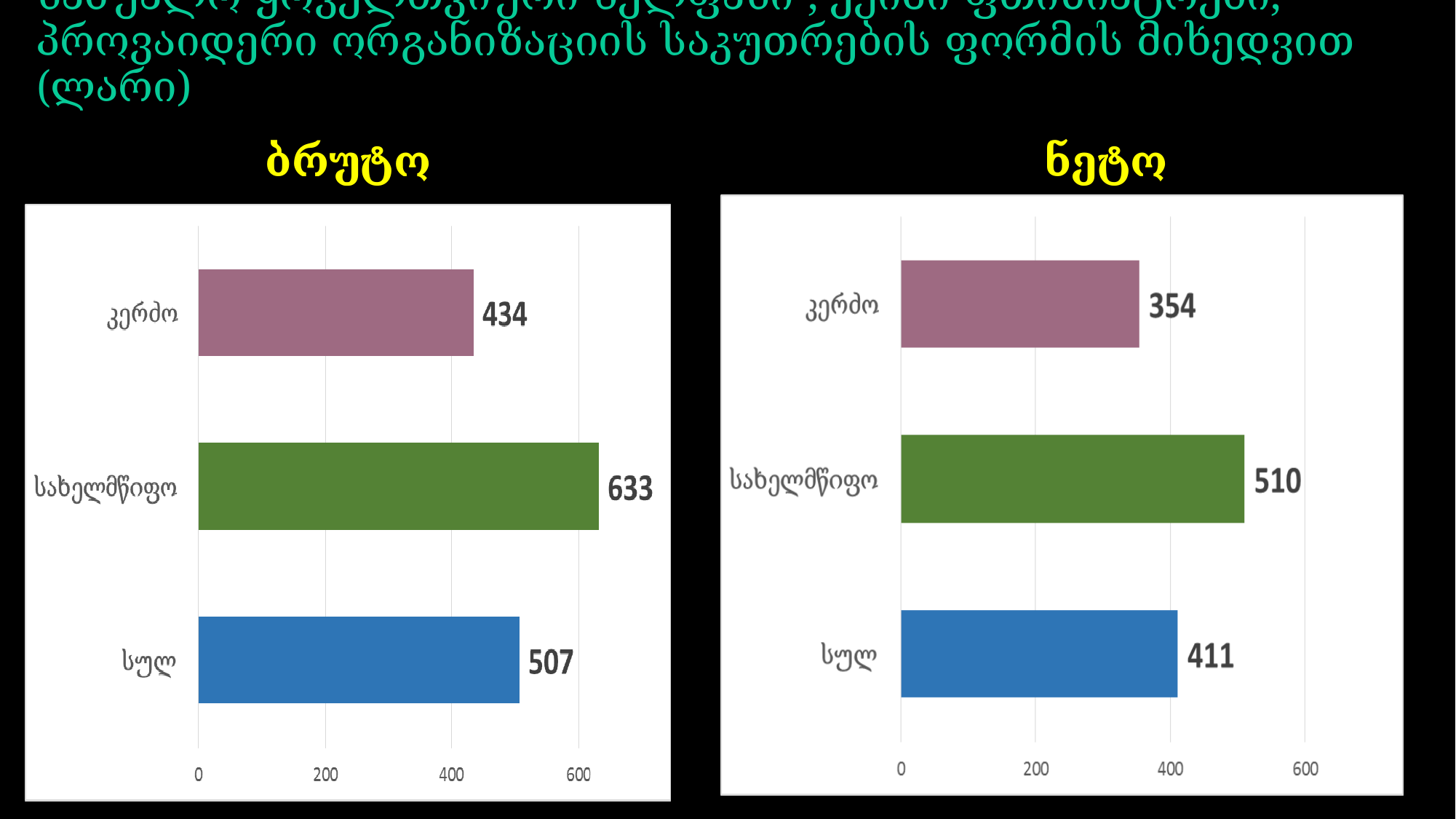
In the ნეტო chart, what is the value for კერძო? 354 What kind of chart is the ბრუტო chart? bar chart In the ნეტო chart, what is the difference between the values for სახელმწიფო and სულ? 99 In the ბრუტო chart, what is the difference between the values for სახელმწიფო and კერძო? 199 In the ბრუტო chart, which category has the highest value? სახელმწიფო How many categories are shown in the ნეტო chart? 3 In the ნეტო chart, which category has the lowest value? კერძო In the ნეტო chart, what is the value for სულ? 411 Which is larger: the value for სულ in the ბრუტო chart or the value for სულ in the ნეტო chart? ბრუტო In the ბრუტო chart, what is the value for სახელმწიფო? 633 What colour is the bar for სახელმწიფო in the ნეტო chart? green In the ბრუტო chart, what is the value for კერძო? 434